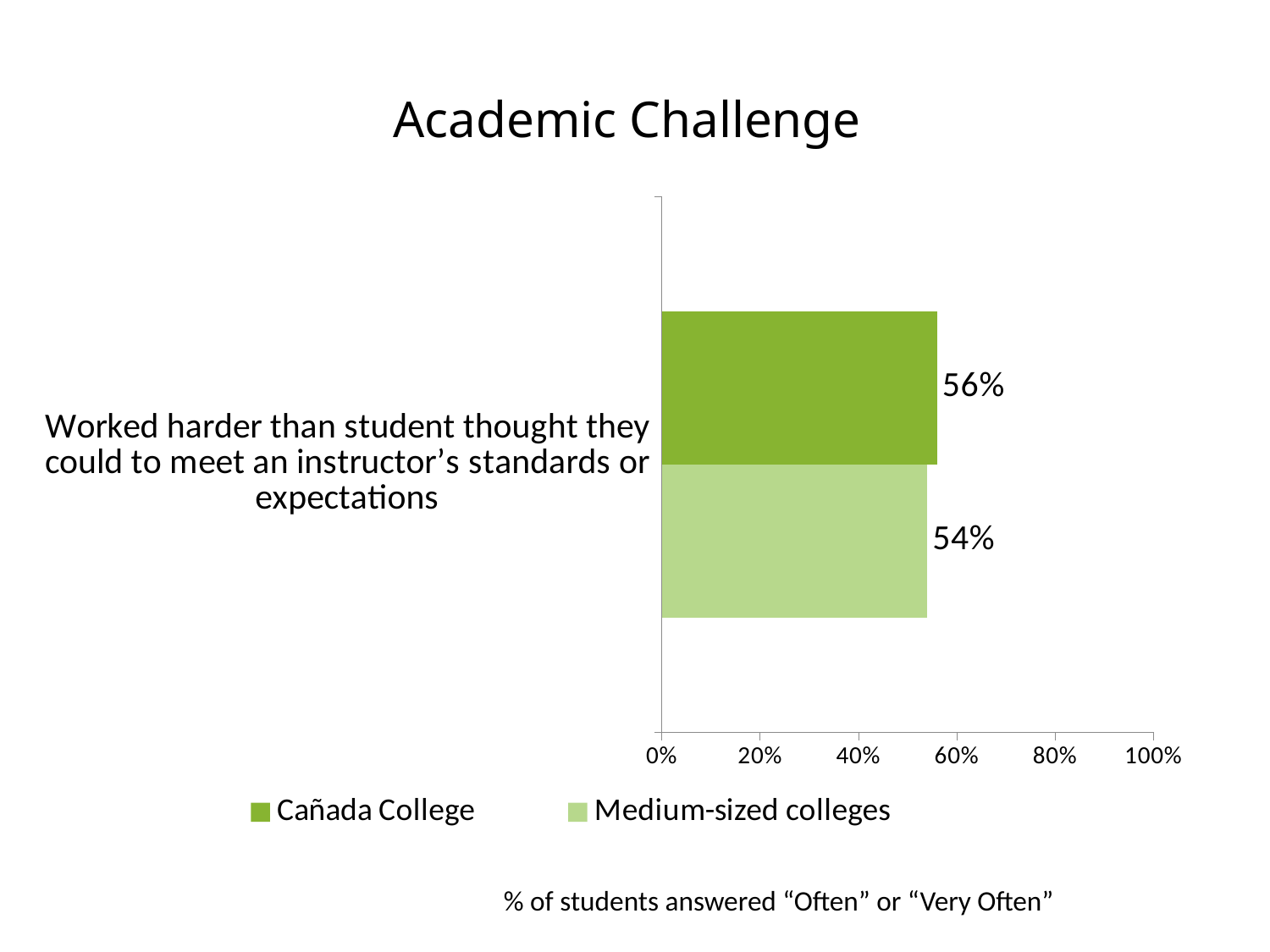
What kind of chart is shown on the slide? Bar chart What is the difference between the Cañada College value and the Medium-sized colleges value? 2% What is the value for Cañada College? 56% How many categories are shown on the chart? 1 Is the value for Cañada College greater or less than 40%? greater What is the value for Medium-sized colleges? 54% Which series has the higher value, Cañada College or Medium-sized colleges? Cañada College Is the value for Medium-sized colleges greater or less than 80%? less Which series is shown in the darker green colour? Cañada College What is the maximum value shown on the x axis? 100% How many series does the legend list? 2 What is the title of the chart? Academic Challenge